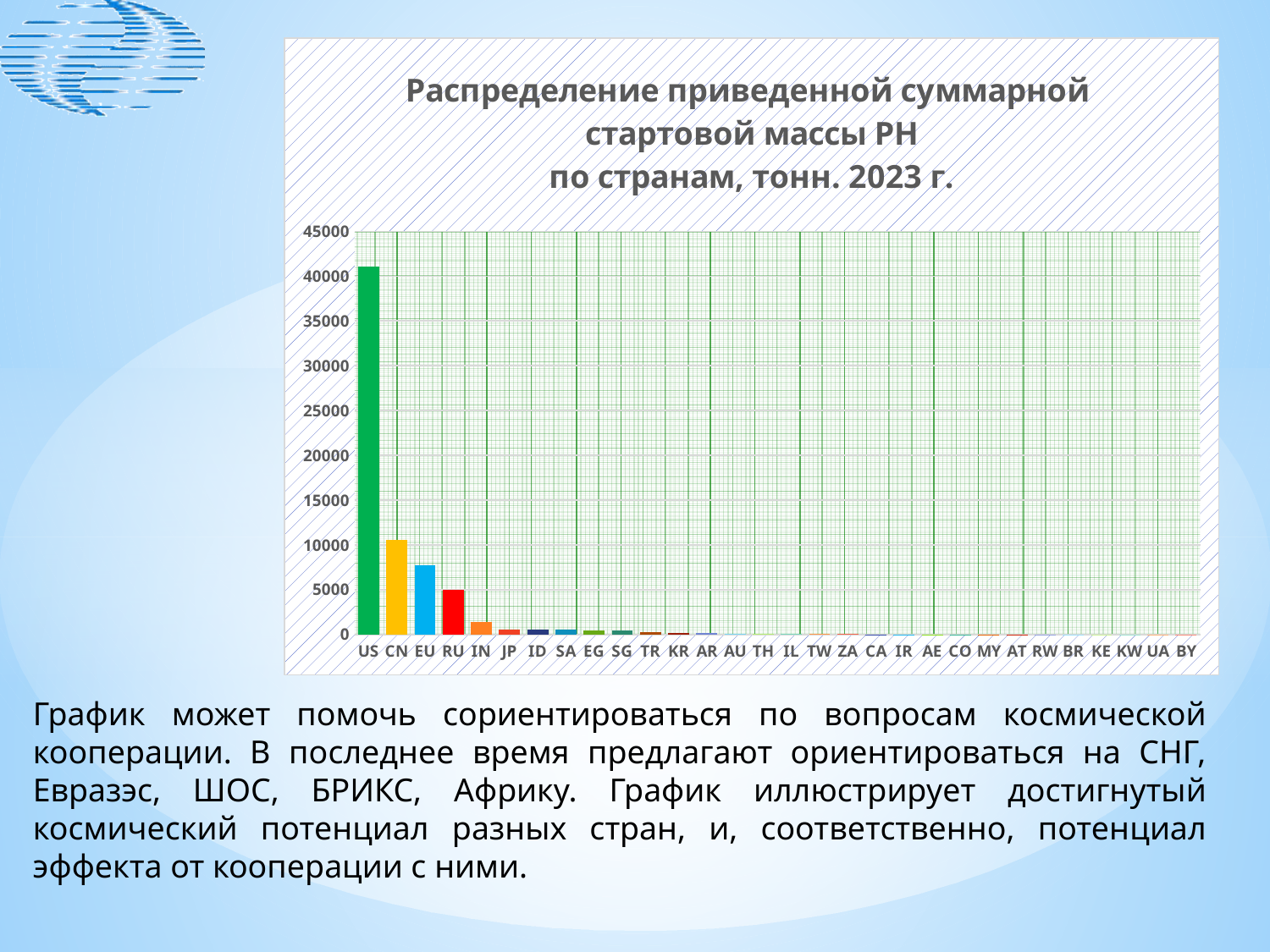
Which country has the highest value in the chart? US Is the value for IN greater or less than 5000? less Is the value for US greater or less than 40000? greater Which is larger, the value for US or the value for CN? US Is the value for EU greater or less than 10000? less Which is larger, the value for EU or the value for RU? EU How many countries (categories) are shown on the x axis of the chart? 30 Do the values rise or fall moving from left to right along the x axis? fall What kind of chart is shown on the slide? bar chart What is the highest value shown on the vertical axis of the chart? 45000